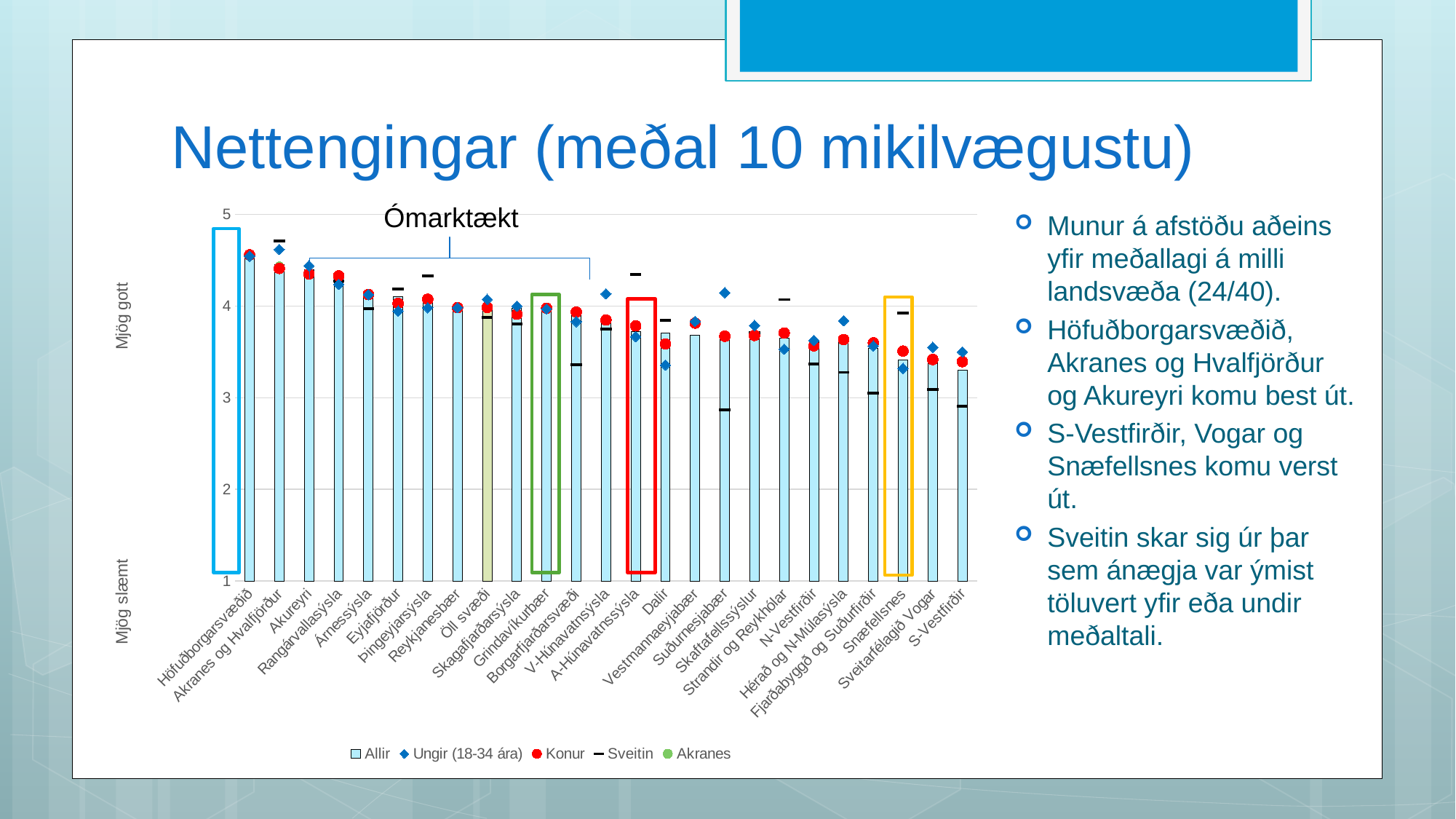
Is the Allir bar for Dalir greater or less than 4? less Is the Allir bar for Höfuðborgarsvæðið greater or less than 4? greater Is the Allir bar for Akureyri greater or less than 3? greater How many categories are shown along the x axis? 25 Do the Allir bars rise or fall from left to right along the x axis? fall Which has the larger Allir bar, Akureyri or Dalir? Akureyri Which category has the lowest bar (Allir)? S-Vestfirðir Which category has the highest bar (Allir)? Höfuðborgarsvæðið What is the title of the slide containing the chart? Nettengingar (meðal 10 mikilvægustu) How many series does the legend list? 5 What kind of chart is shown on the slide? bar chart